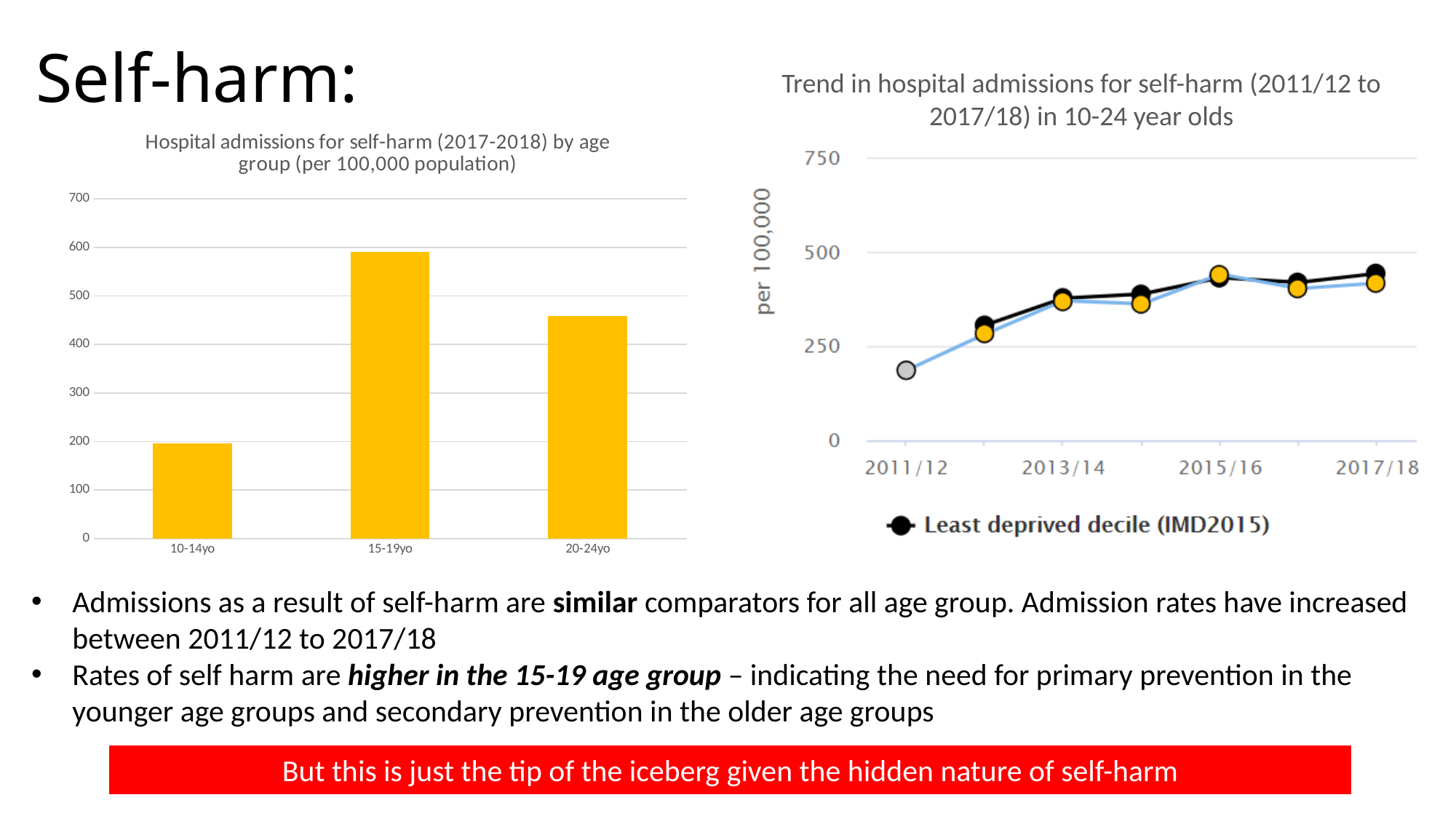
What series name is shown in the legend of the line chart on the right? Least deprived decile (IMD2015) In the bar chart on the left, is the value for 15-19yo greater or less than 500? greater In the bar chart titled 'Hospital admissions for self-harm (2017-2018) by age group', which age group has the lowest value? 10-14yo In the bar chart titled 'Hospital admissions for self-harm (2017-2018) by age group', which age group has the highest value? 15-19yo In the line chart on the right, is the value for 2011/12 greater or less than 250? less What kind of chart is the chart titled 'Trend in hospital admissions for self-harm (2011/12 to 2017/18) in 10-24 year olds'? Line chart In the line chart on the right, do the values generally rise or fall from 2011/12 to 2017/18? Rise In the bar chart on the left, which is larger: the value for 20-24yo or the value for 10-14yo? 20-24yo How many age groups are shown in the bar chart on the left? 3 In the bar chart on the left, is the value for 20-24yo greater or less than 400? greater What kind of chart is the chart on the left of the slide? Bar chart